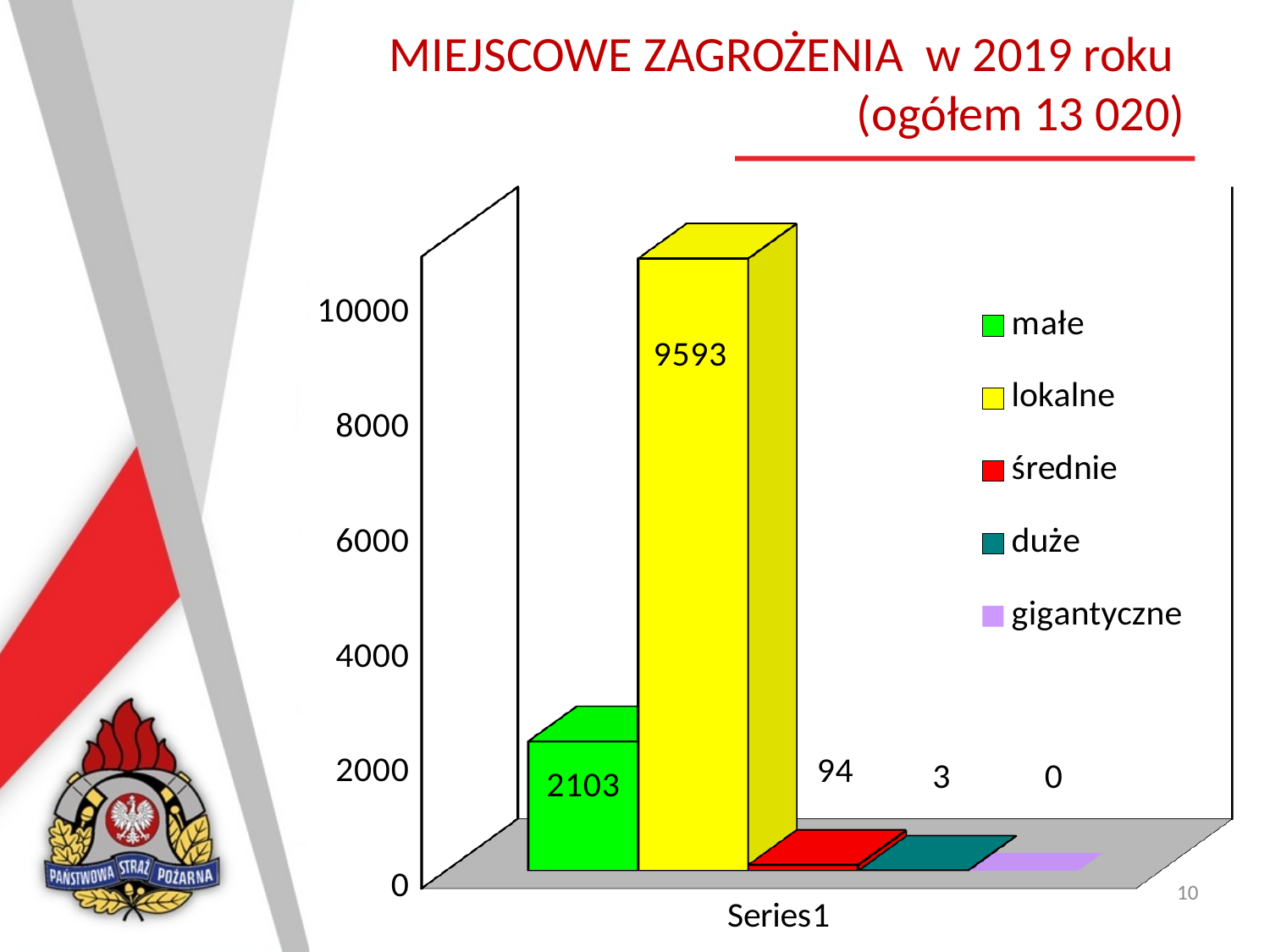
What is the difference between the values for lokalne and małe? 7490 What is the value for lokalne? 9593 What is the value for gigantyczne? 0 Which category has the lowest value? gigantyczne What is the value for duże? 3 What is the value for średnie? 94 What kind of chart is shown on the slide? bar chart What colour is the bar for lokalne? yellow How many categories does the legend list? 5 Which is larger, the value for małe or the value for średnie? małe What is the value for małe? 2103 Which category has the highest value? lokalne